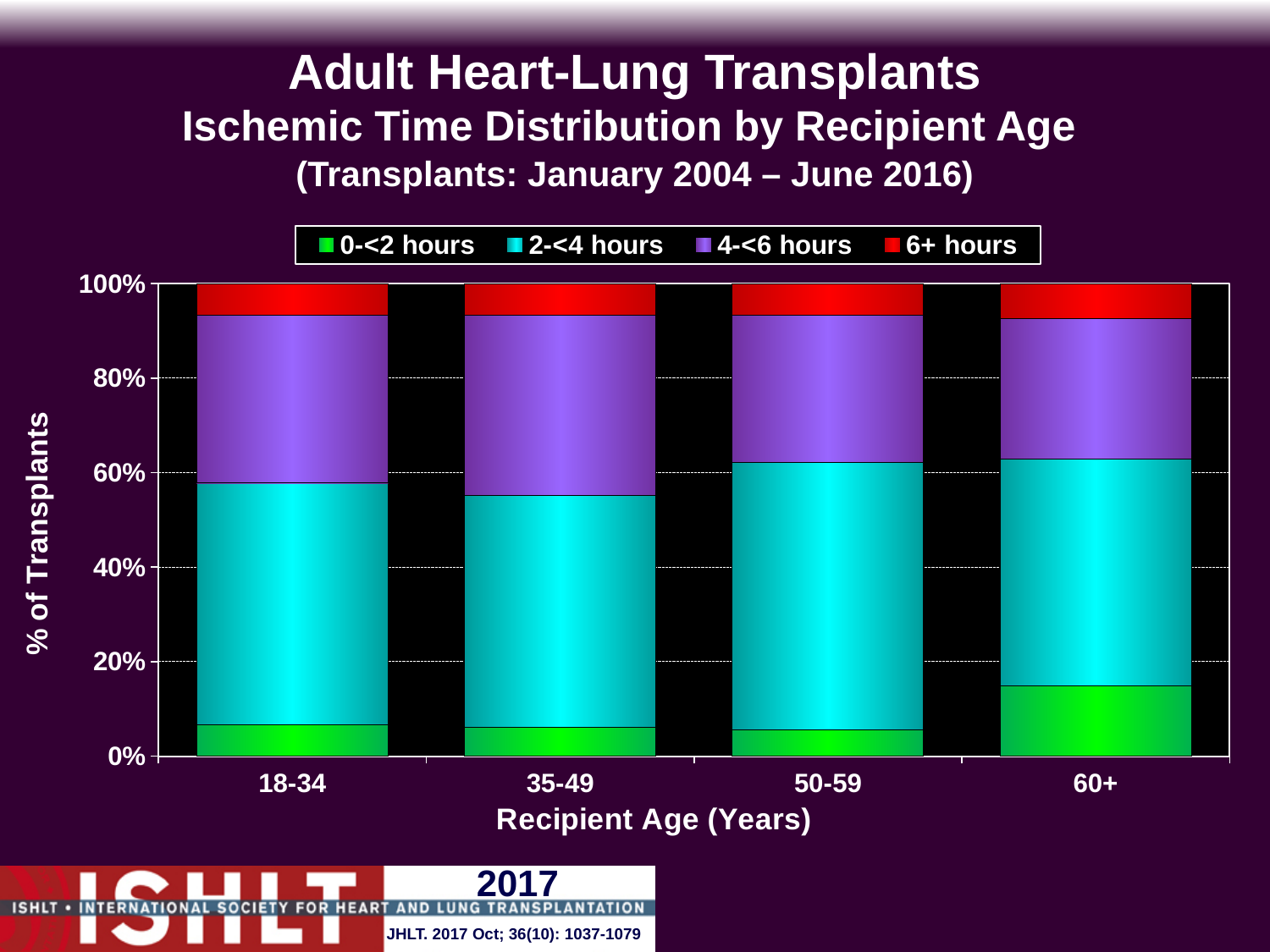
How many ischemic time categories does the legend list? 4 What kind of chart is shown on the slide? Stacked bar chart What does each stacked bar total? 100% Which recipient age group has the largest 4-<6 hours share? 35-49 Which recipient age group has the largest 0-<2 hours share? 60+ Which is larger: the 2-<4 hours share for the 50-59 group or for the 35-49 group? 50-59 How many recipient age groups are shown on the x axis? 4 Which colour represents the 6+ hours category in the legend? Red What is the label of the y axis? % of Transplants Which is larger: the 0-<2 hours share for the 60+ group or for the 18-34 group? 60+ Is the 0-<2 hours share for the 60+ age group greater or less than 20%? less Is the 0-<2 hours share for the 18-34 age group greater or less than 20%? less